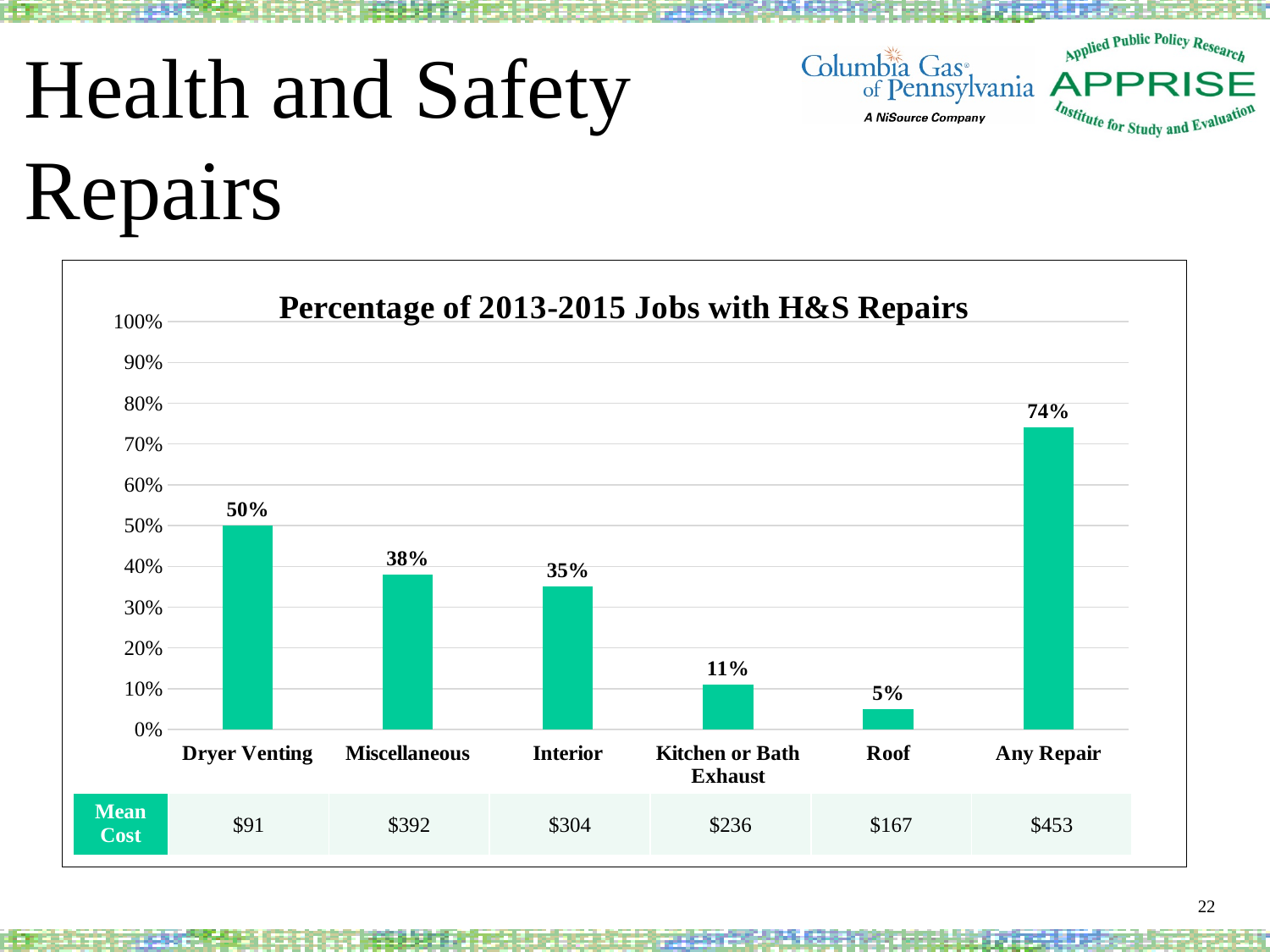
Which category has the lowest percentage of jobs with H&S repairs? Roof Is the value for Any Repair greater or less than 70%? greater What percentage of jobs had Dryer Venting repairs? 50% Which category has the highest percentage of jobs with H&S repairs? Any Repair What is the mean cost shown for Miscellaneous repairs? $392 Which is larger, the percentage for Miscellaneous or for Interior? Miscellaneous What percentage of jobs had Kitchen or Bath Exhaust repairs? 11% How many categories are shown on the x axis of the chart? 6 What is the title of the chart? Percentage of 2013-2015 Jobs with H&S Repairs What is the mean cost shown for Any Repair? $453 What kind of chart is shown on the slide? Bar chart What is the difference in percentage points between Dryer Venting and Interior? 15%